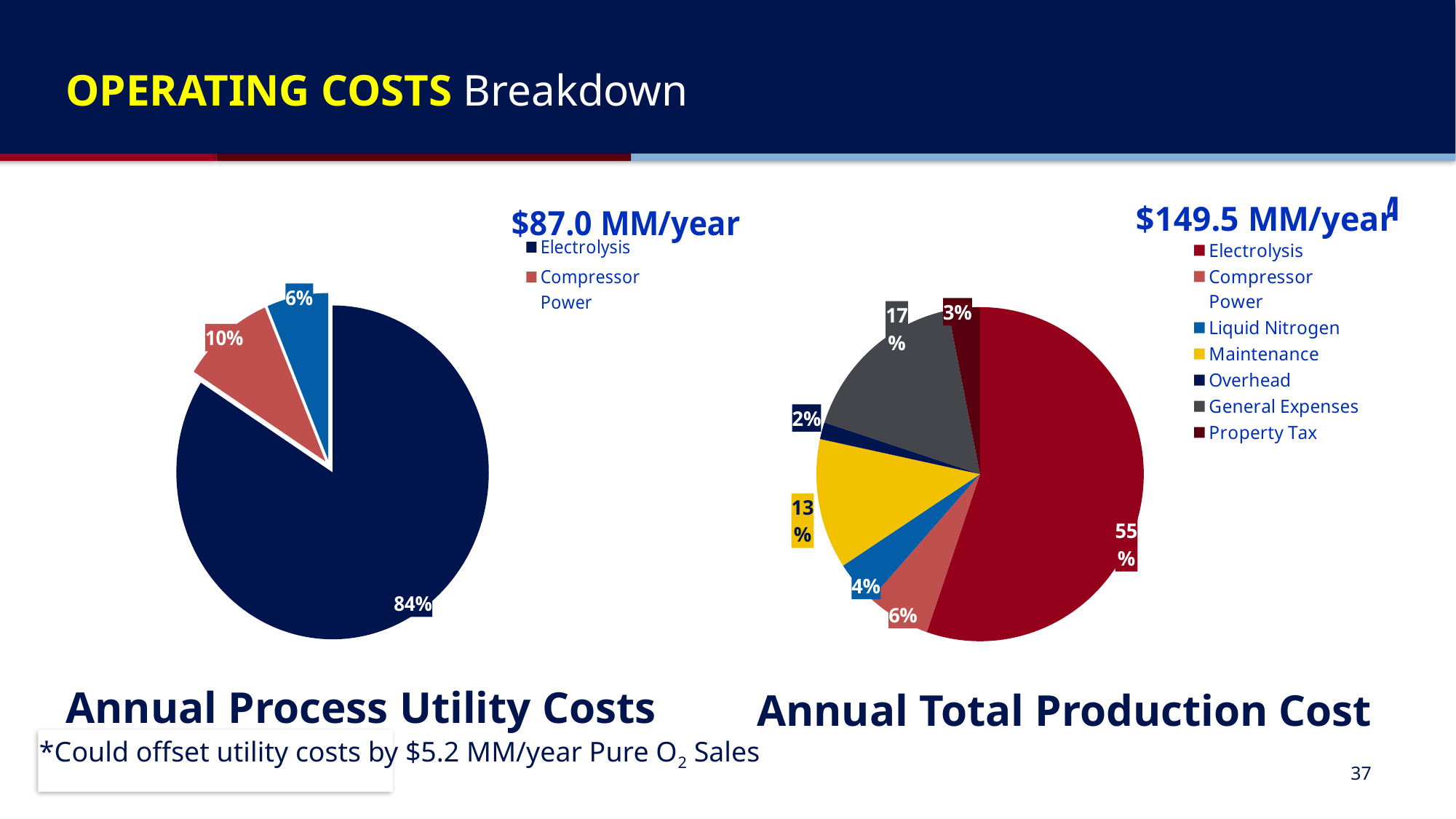
What kind of chart is the Annual Process Utility Costs chart? Pie chart On the Annual Total Production Cost chart, what share is Maintenance? 13% On the Annual Total Production Cost chart, what is the difference in percentage points between Electrolysis and General Expenses? 38 percentage points On the Annual Process Utility Costs chart, which category has the largest slice? Electrolysis On the Annual Total Production Cost chart, what share is Electrolysis? 55% On the Annual Total Production Cost chart, which is larger: Maintenance or Compressor Power? Maintenance How many categories does the legend of the Annual Total Production Cost chart list? 7 How many slices does the Annual Process Utility Costs pie chart have? 3 On the Annual Total Production Cost chart, which category has the smallest slice? Overhead On the Annual Process Utility Costs chart, what share of costs is Compressor Power? 10% On the Annual Process Utility Costs chart, what share of costs is Electrolysis? 84% On the Annual Total Production Cost chart, what share is General Expenses? 17%